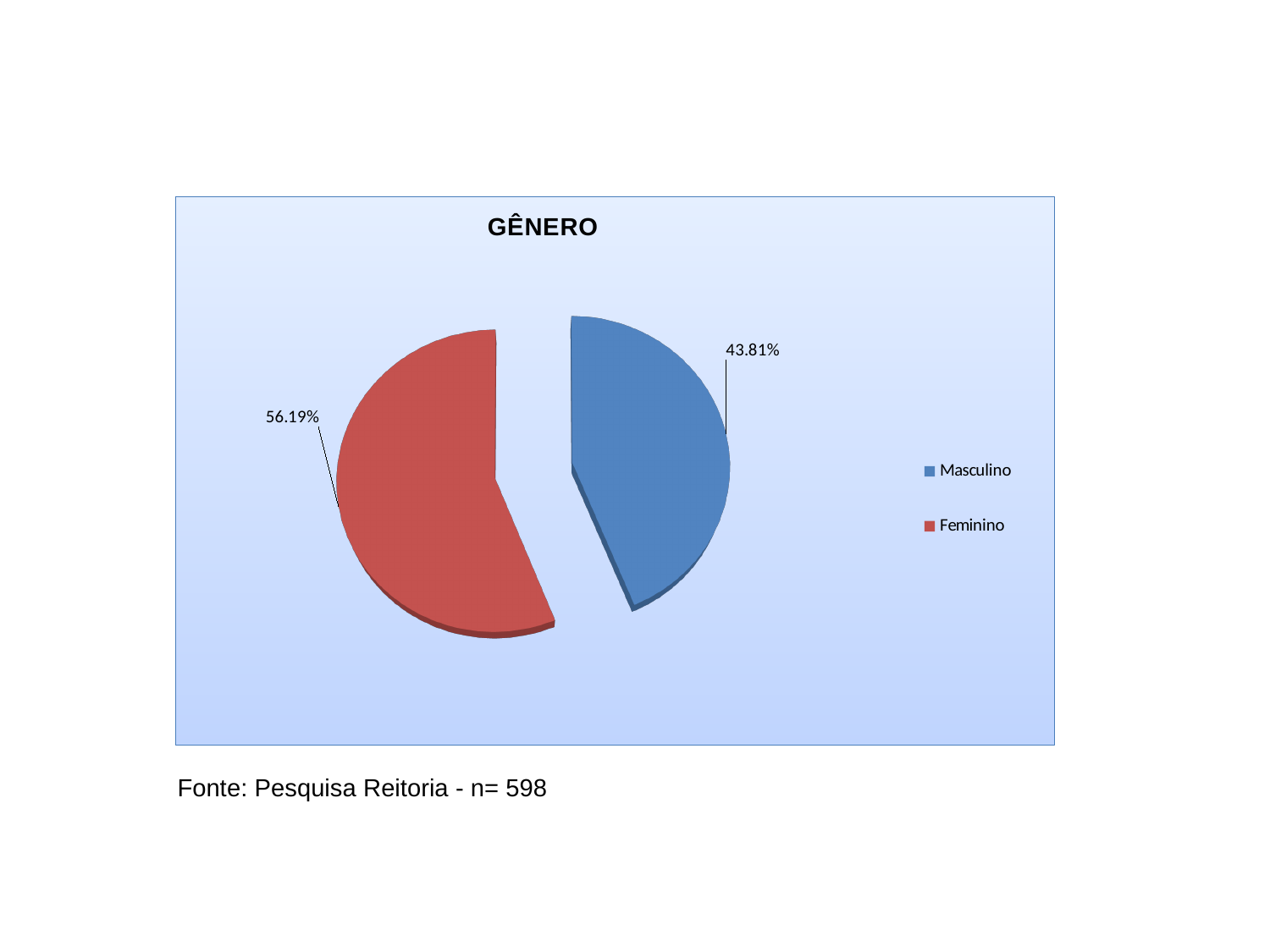
What kind of chart is shown on the slide? Pie chart How many entries does the legend list? 2 Which category has the smallest share of the pie? Masculino What is the value for Feminino? 56.19% Which category has the largest share of the pie? Feminino Which is larger, the share for Masculino or the share for Feminino? Feminino What is the value for Masculino? 43.81% How many slices does the pie chart have? 2 What is the title of the chart? GÊNERO What share of the pie does Feminino represent? 56.19% What colour is the Masculino slice? Blue What is the difference between the Feminino and Masculino shares? 12.38%